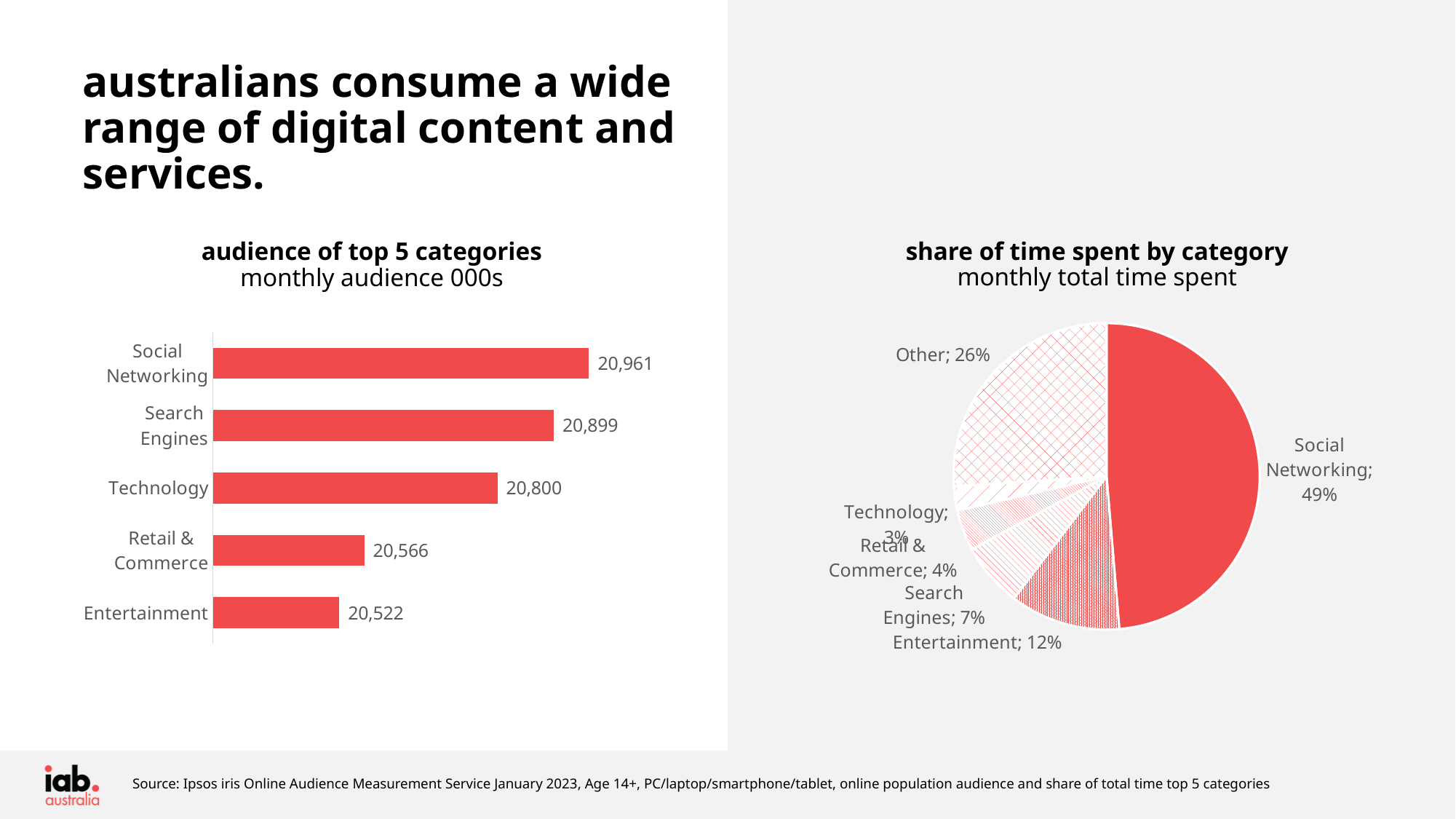
In the 'share of time spent by category' chart, what share of time is spent on Social Networking? 49% What kind of chart is the 'share of time spent by category' chart? Pie chart In the 'share of time spent by category' chart, which is larger: the share for Search Engines or the share for Retail & Commerce? Search Engines What kind of chart is the 'audience of top 5 categories' chart? Bar chart In the 'share of time spent by category' chart, which category has the smallest share? Technology In the 'audience of top 5 categories' chart, how many categories are shown? 5 In the 'audience of top 5 categories' chart, what is the difference between the Social Networking and Entertainment values? 439 In the 'audience of top 5 categories' chart, what is the monthly audience for Social Networking? 20,961 In the 'audience of top 5 categories' chart, what is the value for Retail & Commerce? 20,566 In the 'audience of top 5 categories' chart, which category has the lowest monthly audience? Entertainment In the 'audience of top 5 categories' chart, which category has the highest monthly audience? Social Networking In the 'share of time spent by category' chart, what share of time is spent on Entertainment? 12%